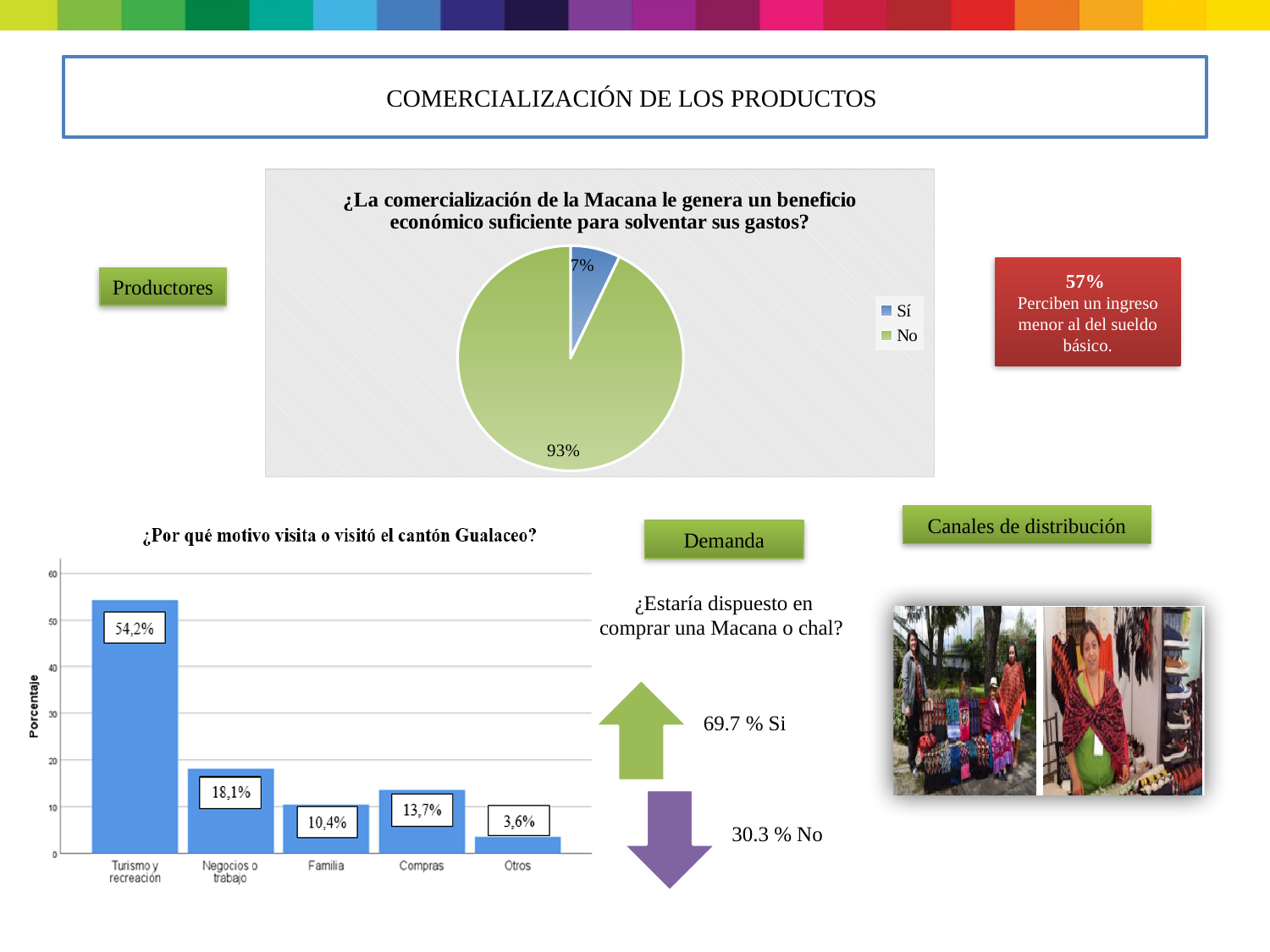
What kind of chart is the one at the bottom left of the slide, titled "¿Por qué motivo visita o visitó el cantón Gualaceo?"? Bar chart In the bar chart "¿Por qué motivo visita o visitó el cantón Gualaceo?", how many categories are shown on the x axis? 5 In the bar chart "¿Por qué motivo visita o visitó el cantón Gualaceo?", which category has the lowest value? Otros In the bar chart "¿Por qué motivo visita o visitó el cantón Gualaceo?", which category has the highest value? Turismo y recreación In the bar chart "¿Por qué motivo visita o visitó el cantón Gualaceo?", what is the value for "Compras"? 13,7% In the pie chart about whether commercializing the Macana generates sufficient economic benefit, what percentage answered "Sí"? 7% In the pie chart at the top of the slide, which slice is larger, "Sí" or "No"? No In the pie chart about whether commercializing the Macana generates sufficient economic benefit, what percentage answered "No"? 93% In the pie chart at the top of the slide, how many entries does the legend list? 2 In the bar chart "¿Por qué motivo visita o visitó el cantón Gualaceo?", which is larger, "Negocios o trabajo" or "Familia"? Negocios o trabajo In the pie chart at the top of the slide, what is the difference in percentage points between the "No" and "Sí" slices? 86 In the bar chart "¿Por qué motivo visita o visitó el cantón Gualaceo?", what is the value for "Turismo y recreación"? 54,2%